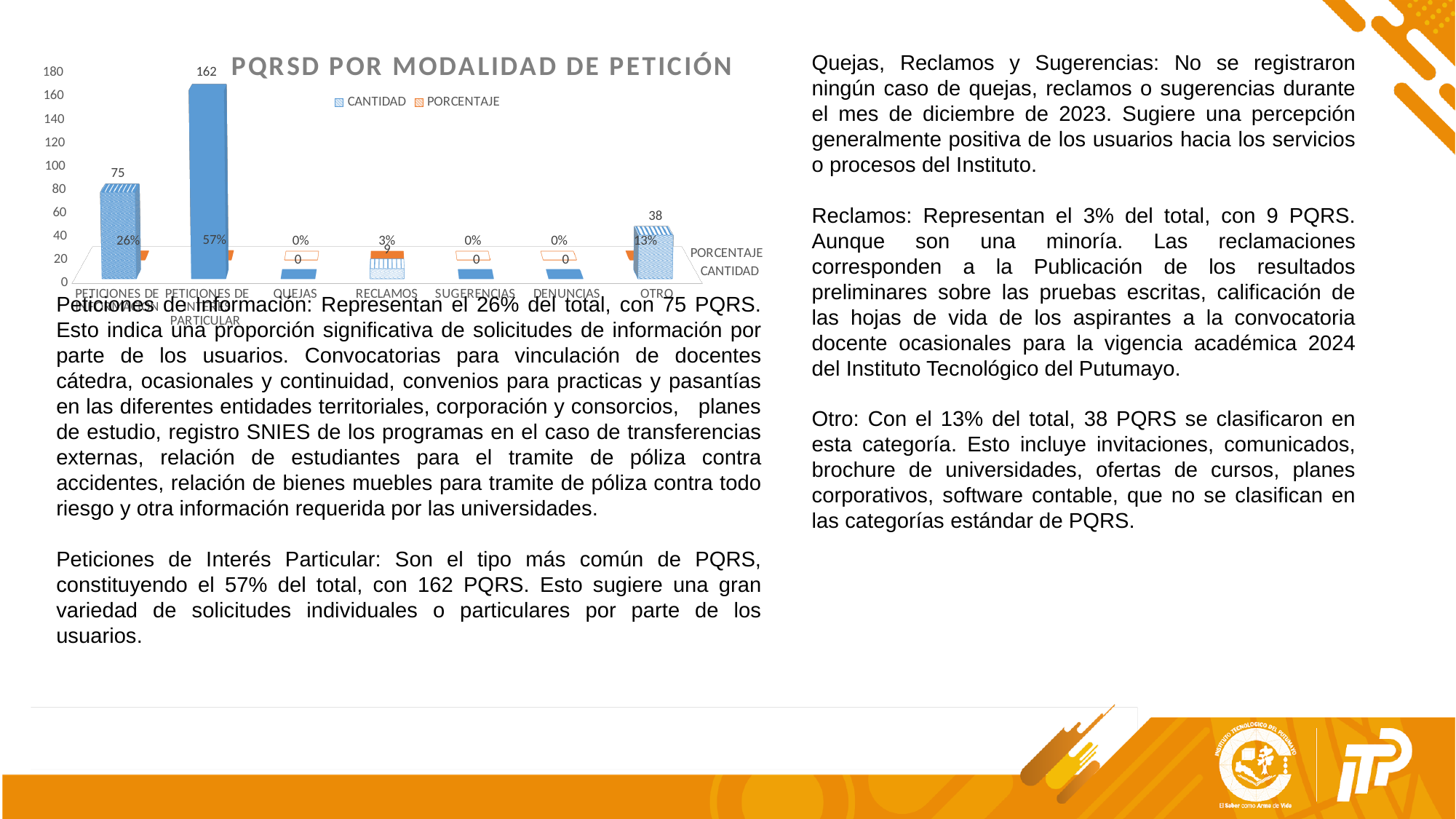
How many categories are shown on the x axis of the chart? 7 What is the CANTIDAD value for OTRO? 38 What is the highest CANTIDAD value shown in the chart? 162 What is the PORCENTAJE value for OTRO? 13% What is the difference between the CANTIDAD values for OTRO and RECLAMOS? 29 What is the CANTIDAD value for QUEJAS? 0 How many series does the legend of the chart list? 2 What is the title of the chart? PQRSD POR MODALIDAD DE PETICIÓN What is the CANTIDAD value for RECLAMOS? 9 Which has a larger CANTIDAD value, OTRO or RECLAMOS? OTRO What is the PORCENTAJE value for RECLAMOS? 3% What kind of chart is shown on the slide? bar chart